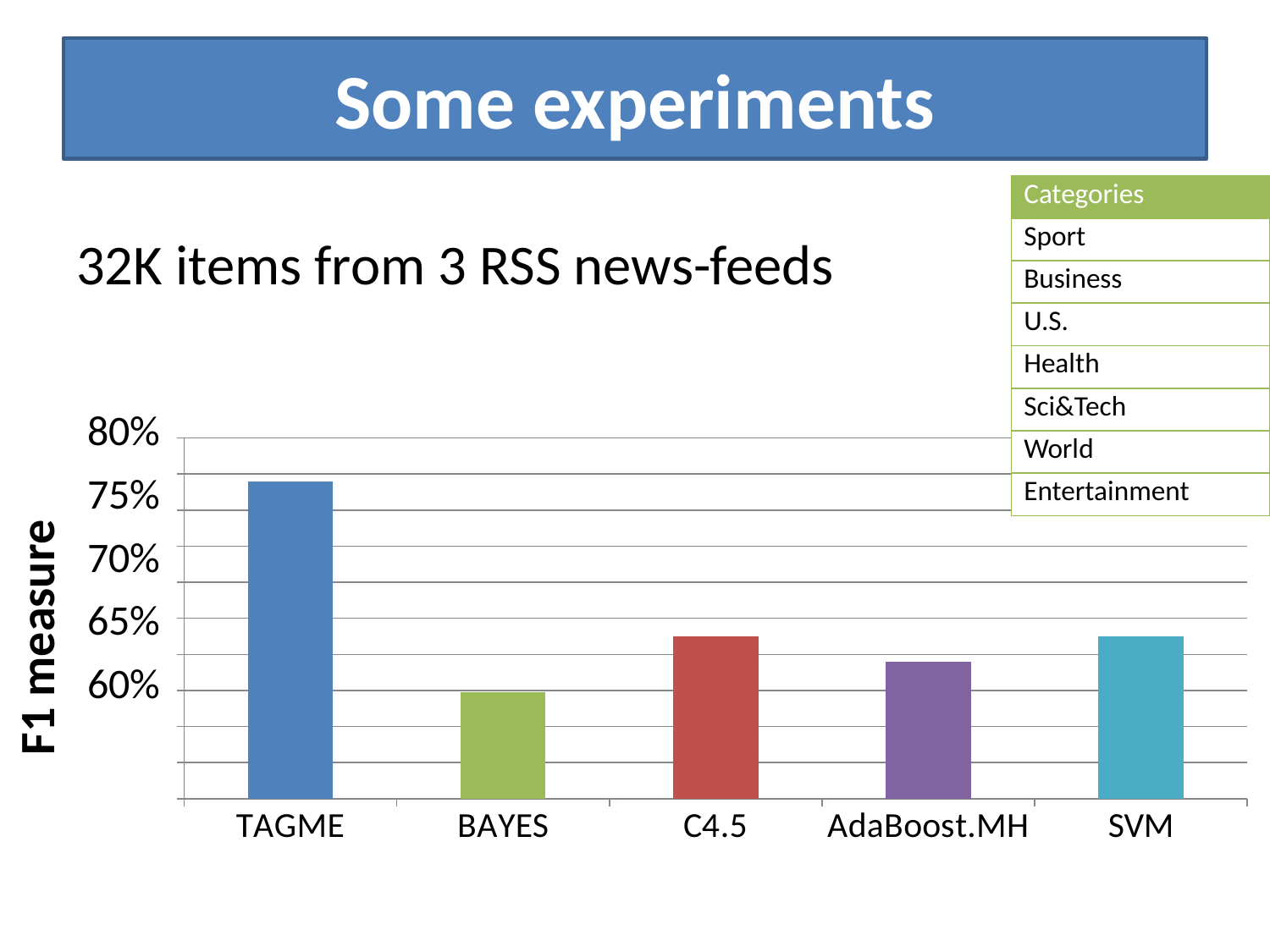
Which method has the lowest F1 measure in the chart? BAYES Which has a higher F1 measure, C4.5 or AdaBoost.MH? C4.5 Is the F1 measure for SVM greater or less than 70%? less Is the F1 measure for C4.5 greater or less than 65%? less Which method has the highest F1 measure in the chart? TAGME How many methods (bars) are plotted in the chart? 5 What is the label of the vertical axis of the chart? F1 measure Which has a higher F1 measure, TAGME or BAYES? TAGME What kind of chart is shown on the slide? bar chart Is the F1 measure for AdaBoost.MH greater or less than 60%? greater Which method's bar is coloured blue in the chart? TAGME